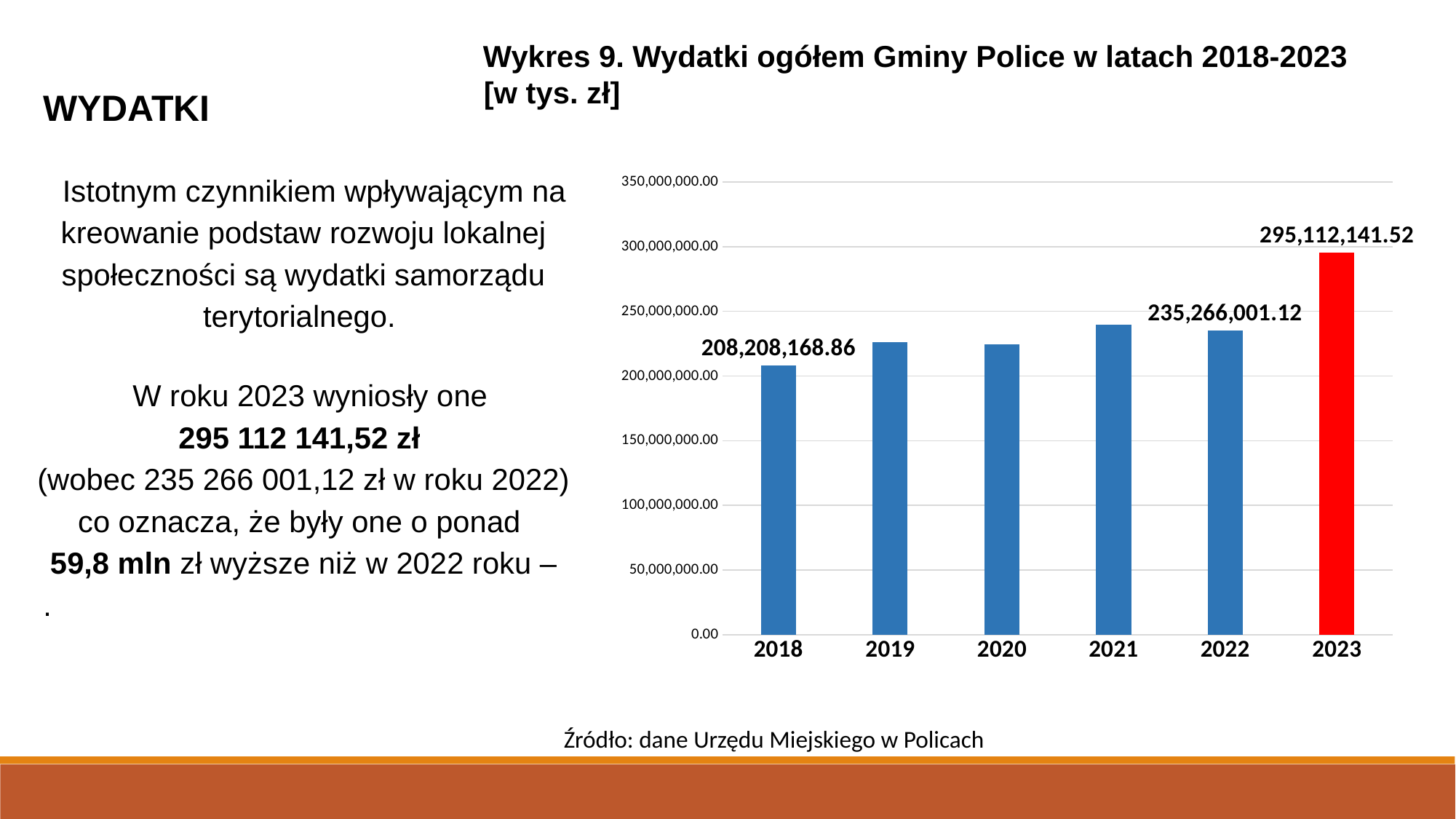
Which is larger, the value for 2018 or the value for 2021? 2021 Is the value for 2019 greater or less than 250,000,000.00? less Which year has the lowest value in the chart? 2018 Which year's bar is coloured red in the chart? 2023 Which year has the highest value in the chart? 2023 What is the value for 2023 in the chart? 295,112,141.52 How many years are shown on the x axis of the chart? 6 Is the value for 2021 greater or less than 200,000,000.00? greater What is the value for 2018 in the chart? 208,208,168.86 What is the value for 2022 in the chart? 235,266,001.12 What kind of chart is shown on the slide? bar chart What is the difference between the values for 2023 and 2022? 59,846,140.40